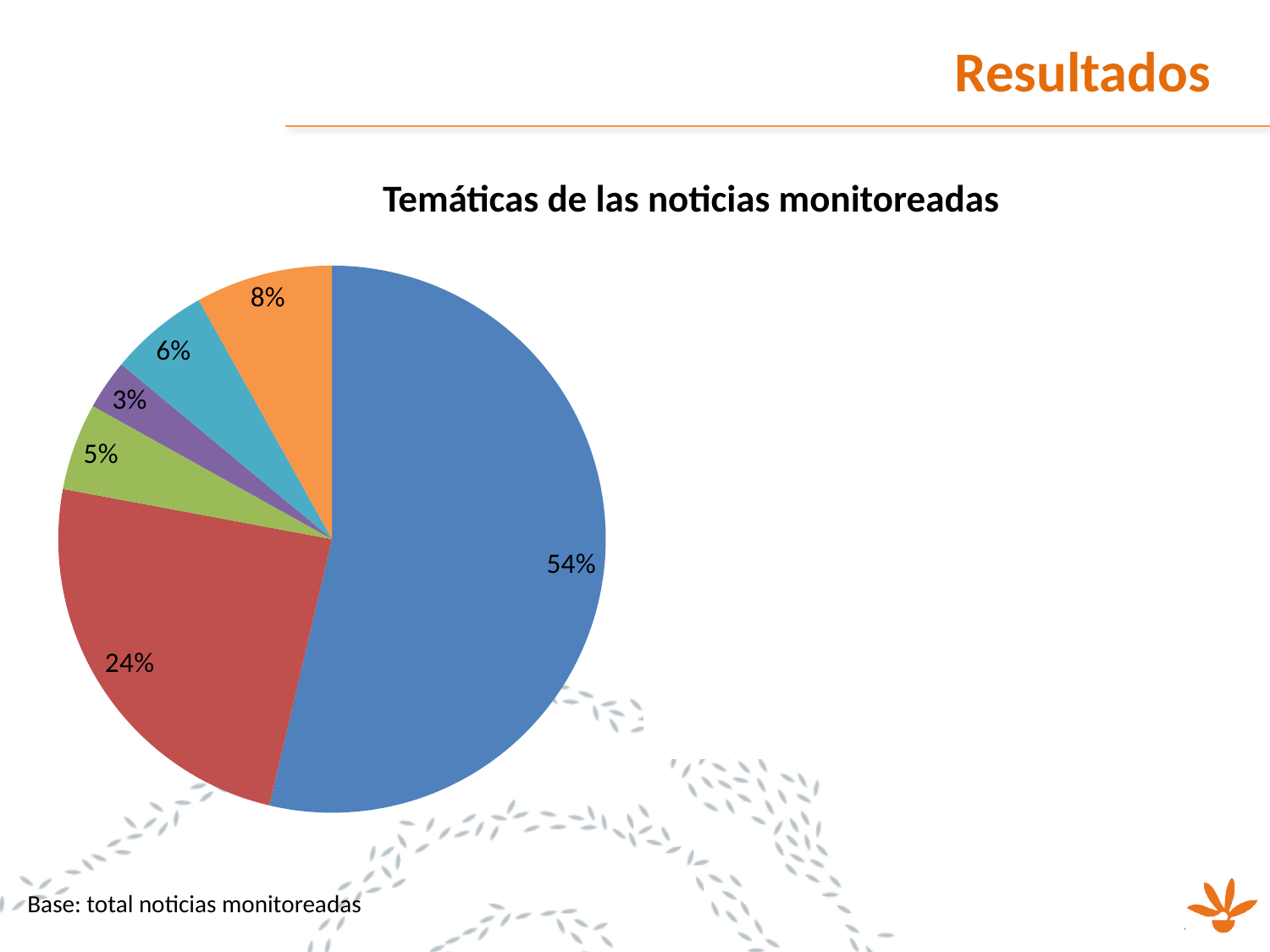
What is the value of the largest slice in the pie chart? 54% How many slices does the pie chart have? 6 What kind of chart is shown on the slide? pie chart What is the difference between the blue slice and the red slice? 30 percentage points What percentage is shown for the largest (blue) slice of the pie? 54% What percentage is shown for the orange slice of the pie? 8% Which colour slice is the smallest in the pie chart? purple (3%) What percentage is shown for the green slice of the pie? 5% What base is stated below the chart? Base: total noticias monitoreadas What is the title of the chart? Temáticas de las noticias monitoreadas Which is larger, the light blue slice or the orange slice? the orange slice (8%) What percentage is shown for the red slice of the pie? 24%